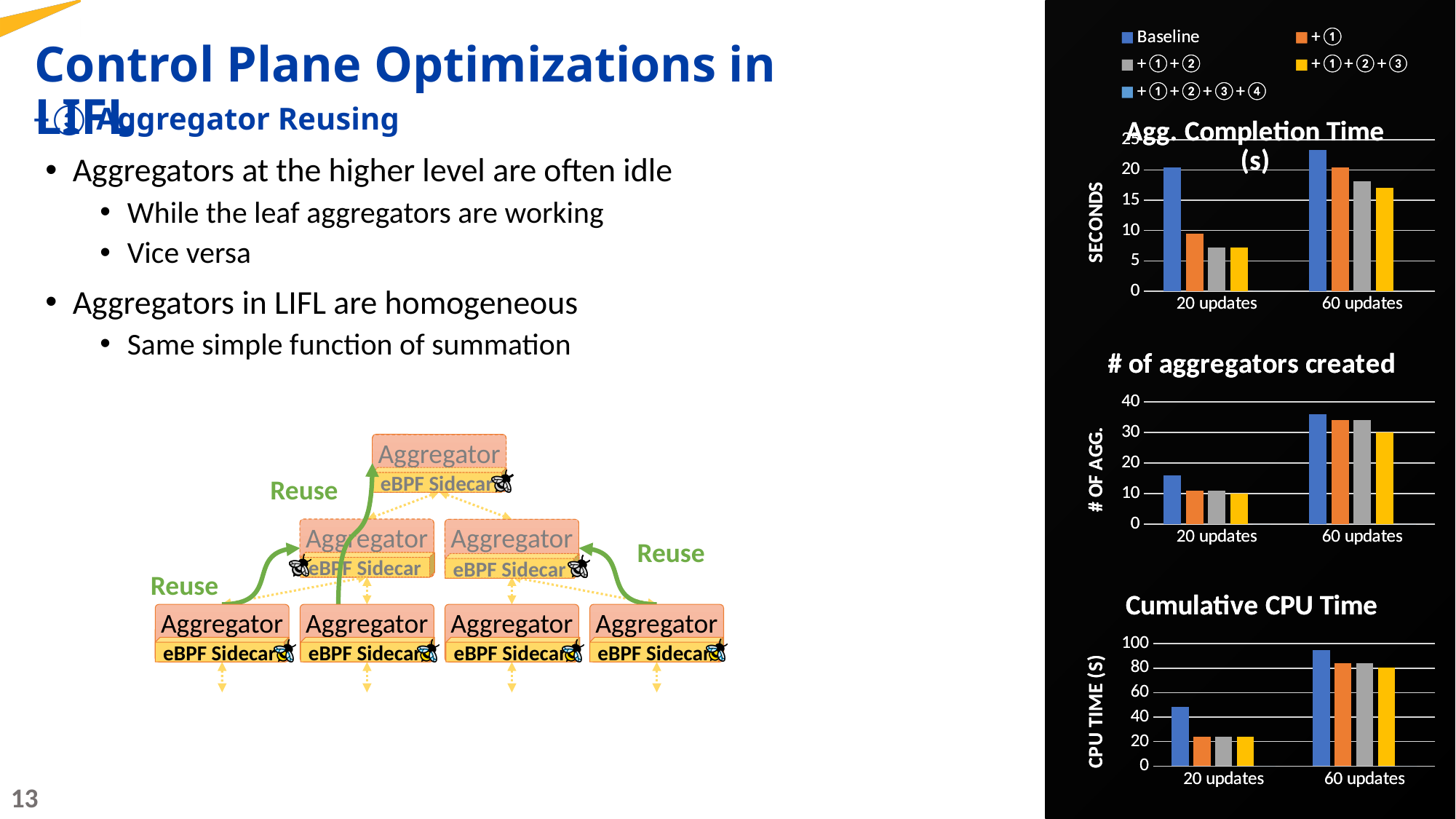
In the 'Cumulative CPU Time' chart, is the Baseline value for 20 updates greater or less than 40? greater What is the y-axis label of the 'Cumulative CPU Time' chart? CPU TIME (S) In the '# of aggregators created' chart, is the Baseline value for 60 updates greater or less than 30? greater In the 'Agg. Completion Time (s)' chart, which series has the highest value for 60 updates? Baseline In the 'Agg. Completion Time (s)' chart, is the Baseline value for 20 updates greater or less than 15? greater In the 'Cumulative CPU Time' chart, does the Baseline value rise or fall from 20 updates to 60 updates? rise How many categories are shown on the x axis of the '# of aggregators created' chart? 2 In the '# of aggregators created' chart, which series has the lowest value for 60 updates? +①+②+③ In the '# of aggregators created' chart, is the Baseline value larger for 20 updates or for 60 updates? 60 updates What kind of chart is the 'Agg. Completion Time (s)' chart? bar chart How many series does the legend at the top of the right panel list? 5